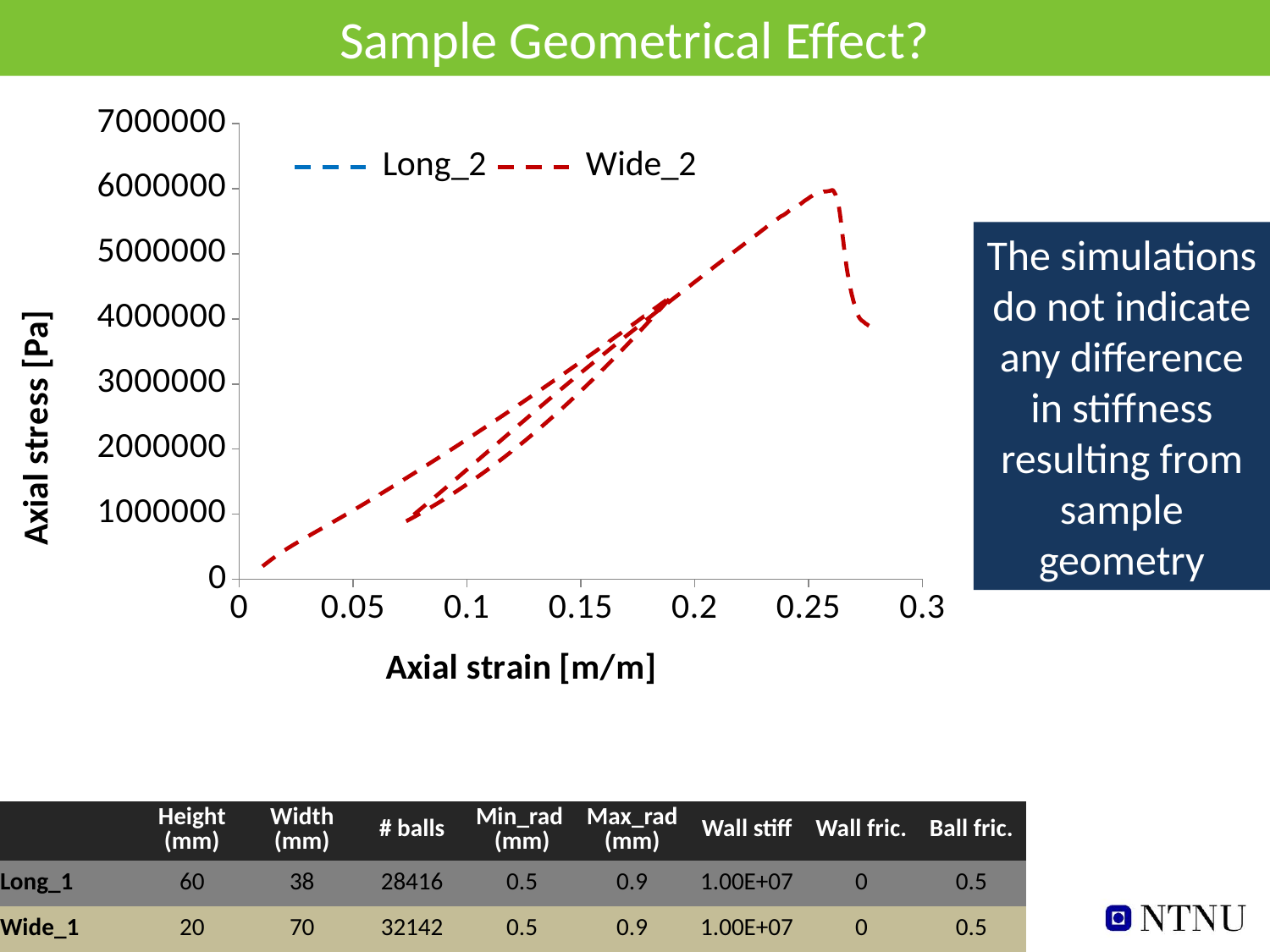
After reaching its peak, does the axial stress of the Wide_2 curve rise or fall as strain increases further? fall How many series does the chart legend list? 2 Is the peak axial stress reached by the Wide_2 curve greater or less than 7000000? less What is the label of the chart's y axis? Axial stress [Pa] What kind of chart is shown on the slide? line chart Is the axial stress of the Wide_2 curve at an axial strain of 0.1 greater or less than 3000000? less What is the highest value shown on the x axis of the chart? 0.3 Does the axial stress generally rise or fall as axial strain increases from 0 to 0.25? rise Does the peak of the Wide_2 curve occur at an axial strain greater or less than 0.2? greater What are the names of the two series in the chart legend? Long_2 and Wide_2